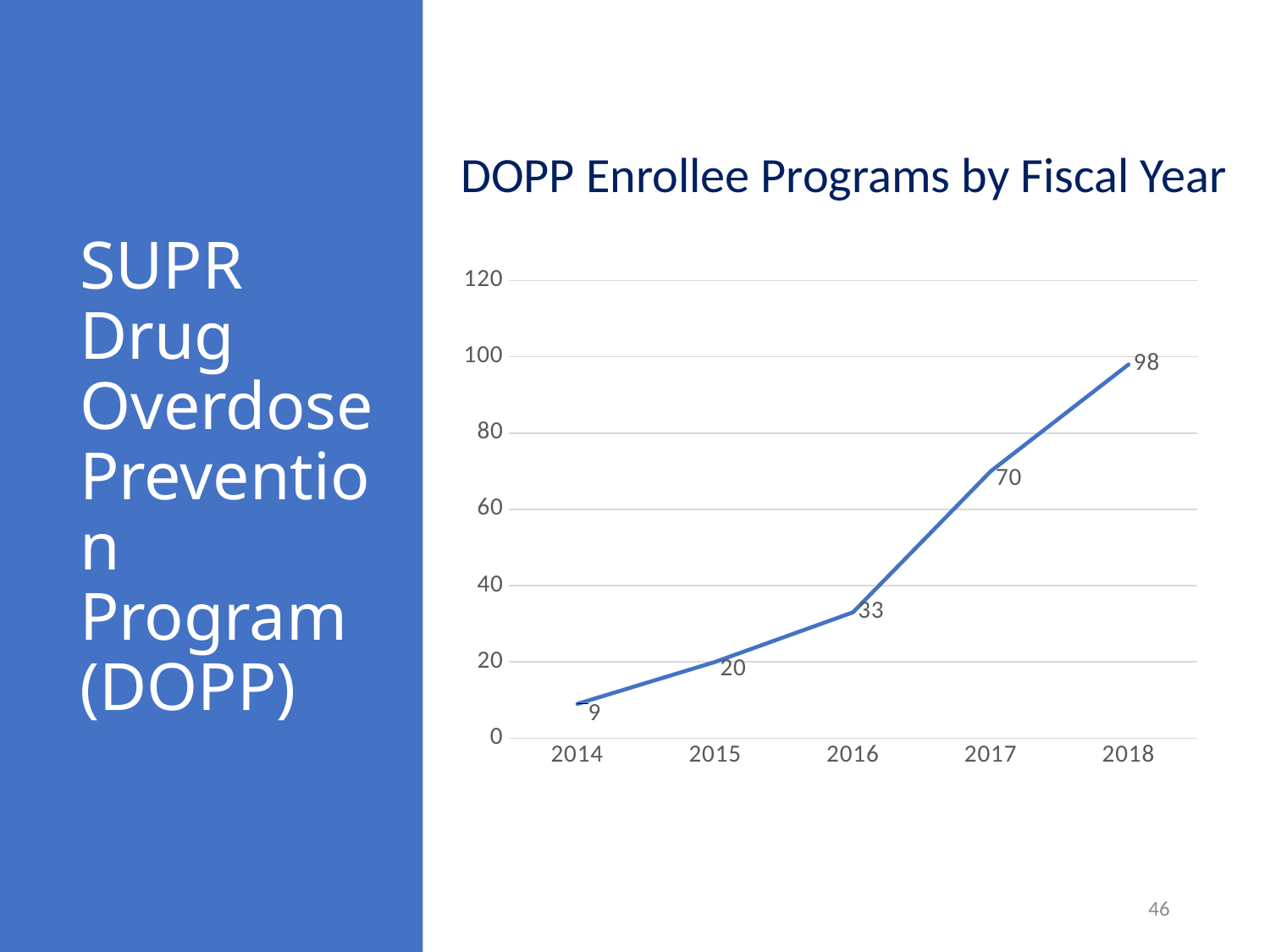
Is the value for 2017 greater or less than 60? greater How many fiscal years are plotted on the chart? 5 Do the values rise or fall from 2014 to 2018? rise What is the value for 2014? 9 What is the difference between the values for 2016 and 2015? 13 What is the value for 2016? 33 Which fiscal year has the highest value? 2018 Which fiscal year has the lowest value? 2014 What is the value for 2018? 98 What is the difference between the values for 2018 and 2017? 28 Which is larger, the value for 2017 or the value for 2016? 2017 What kind of chart is shown on the slide? line chart